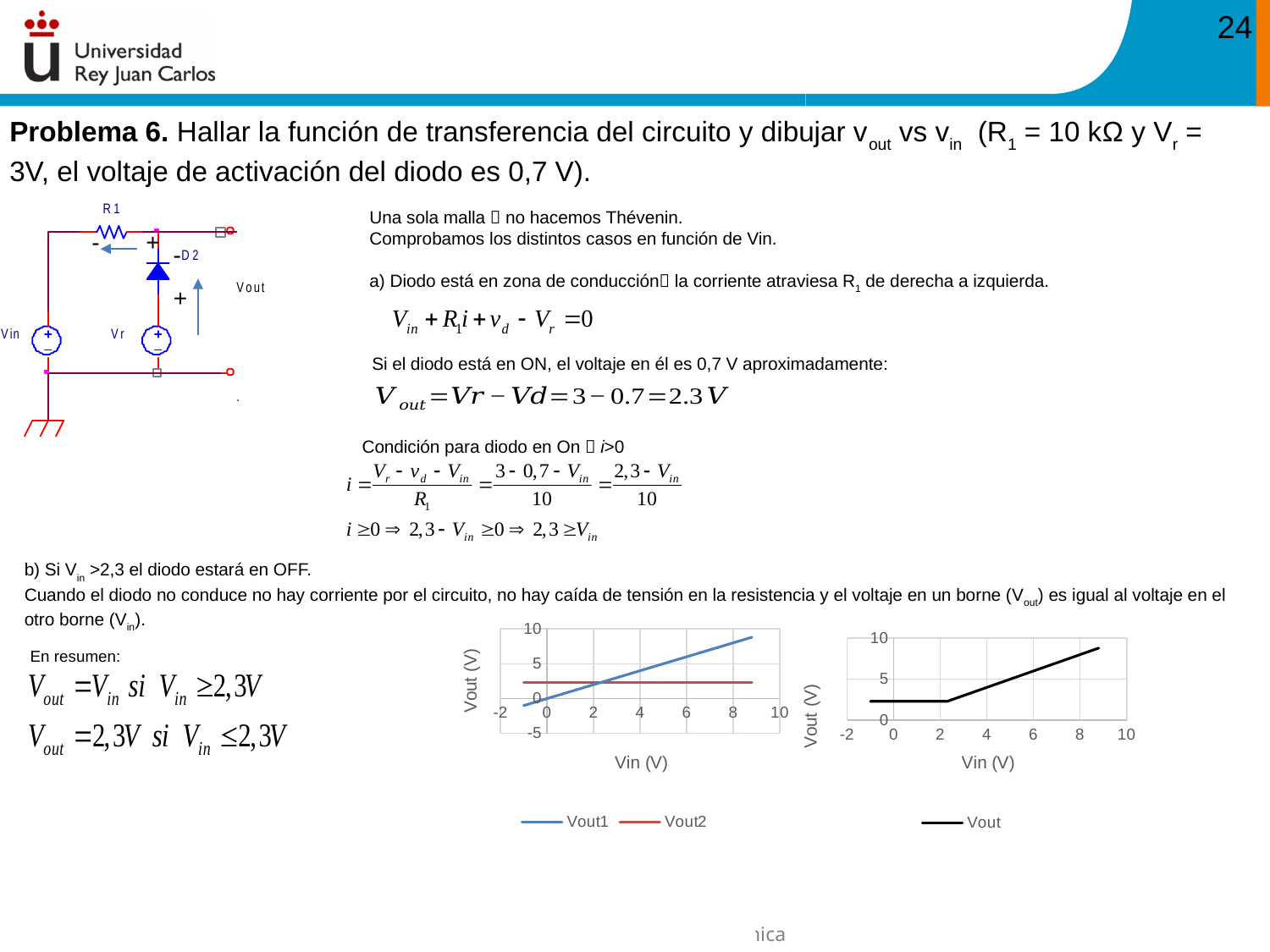
How many series does the legend of the right chart list? 1 In the left chart, at Vin = 8, which series has the larger value, Vout1 or Vout2? Vout1 In the left chart, is the value of Vout1 at Vin = 8 greater or less than 5? greater In the left chart, what are the names of the two series in the legend? Vout1 and Vout2 What kind of chart is the left chart (with Vout1 and Vout2)? line chart What is the x-axis title of the right chart? Vin (V) In the right chart, does Vout rise or fall as Vin increases from 2 to 8? rise In the left chart, is the value of Vout2 greater or less than 5? less How many series does the legend of the left chart list? 2 In the left chart, does Vout2 rise, fall or stay flat as Vin increases? stay flat What kind of chart is the right chart (with Vout)? line chart In the left chart, does Vout1 rise or fall as Vin increases? rise